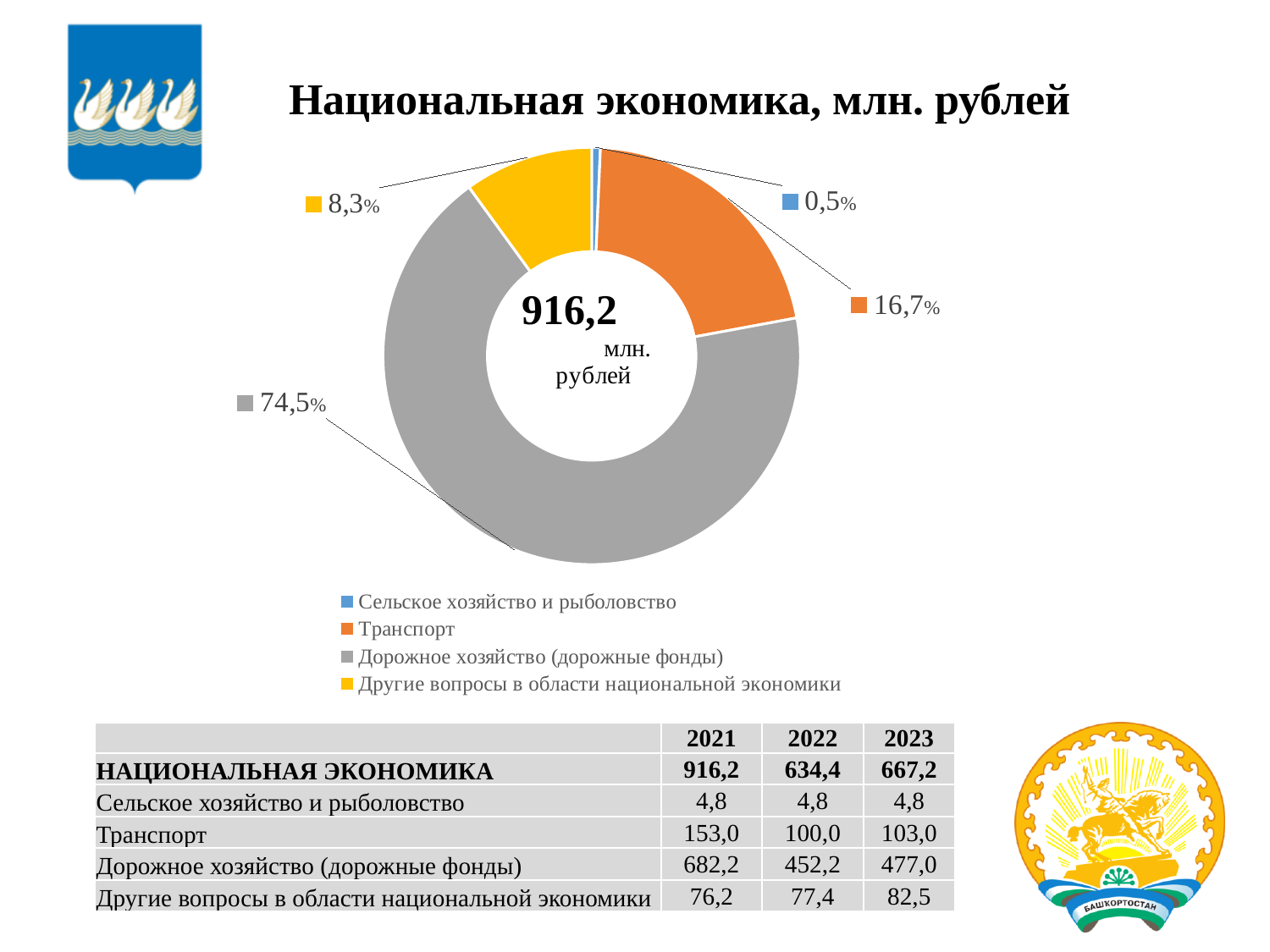
What is the title of the chart? Национальная экономика, млн. рублей How many categories does the doughnut chart's legend list? 4 Which category has the largest slice in the doughnut chart? Дорожное хозяйство (дорожные фонды) What share of the doughnut chart does Дорожное хозяйство (дорожные фонды) take? 74,5% What share of the doughnut chart does Сельское хозяйство и рыболовство take? 0,5% Which category has the smallest slice in the doughnut chart? Сельское хозяйство и рыболовство What share of the doughnut chart does Другие вопросы в области национальной экономики take? 8,3% What is the difference in percentage points between the Дорожное хозяйство (дорожные фонды) slice and the Транспорт slice? 57,8% What total value is printed in the centre of the doughnut chart? 916,2 млн. рублей Which slice is larger: Транспорт or Другие вопросы в области национальной экономики? Транспорт What kind of chart is shown on the slide? doughnut (pie) chart